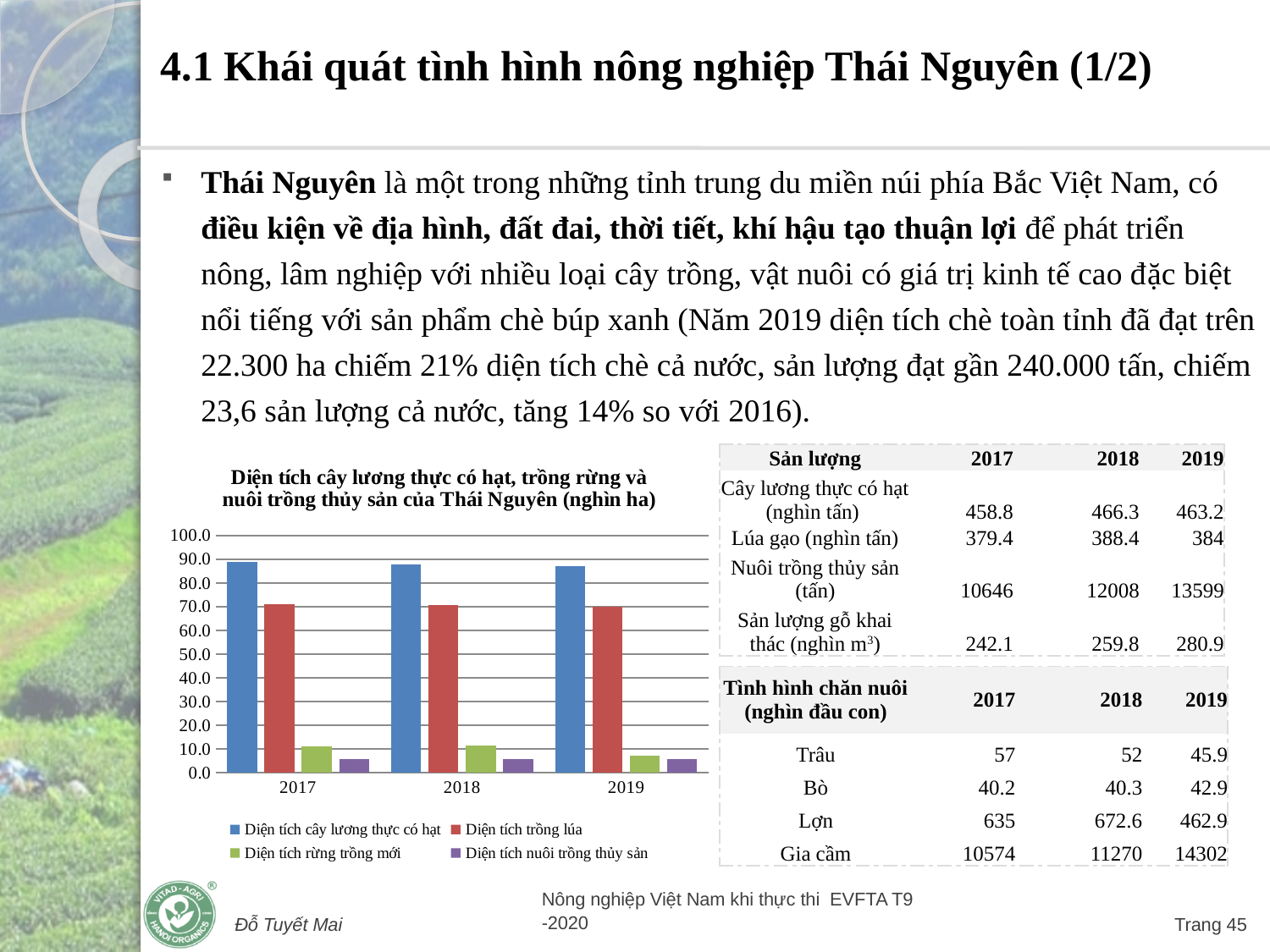
Is the value for Diện tích cây lương thực có hạt in 2017 greater or less than 80? greater What kind of chart is shown on the slide? bar chart Which is larger in 2018: Diện tích cây lương thực có hạt or Diện tích trồng lúa? Diện tích cây lương thực có hạt Is the value for Diện tích rừng trồng mới in 2019 greater or less than 10? less Is the value for Diện tích trồng lúa in 2019 greater or less than 80? less How many years are shown on the x axis of the chart? 3 Which series has the highest value in 2017? Diện tích cây lương thực có hạt For Diện tích rừng trồng mới, which year has the larger value: 2017 or 2019? 2017 How many series does the chart legend list? 4 Which series has the lowest value in 2017? Diện tích nuôi trồng thủy sản What is the title of the chart? Diện tích cây lương thực có hạt, trồng rừng và nuôi trồng thủy sản của Thái Nguyên (nghìn ha)